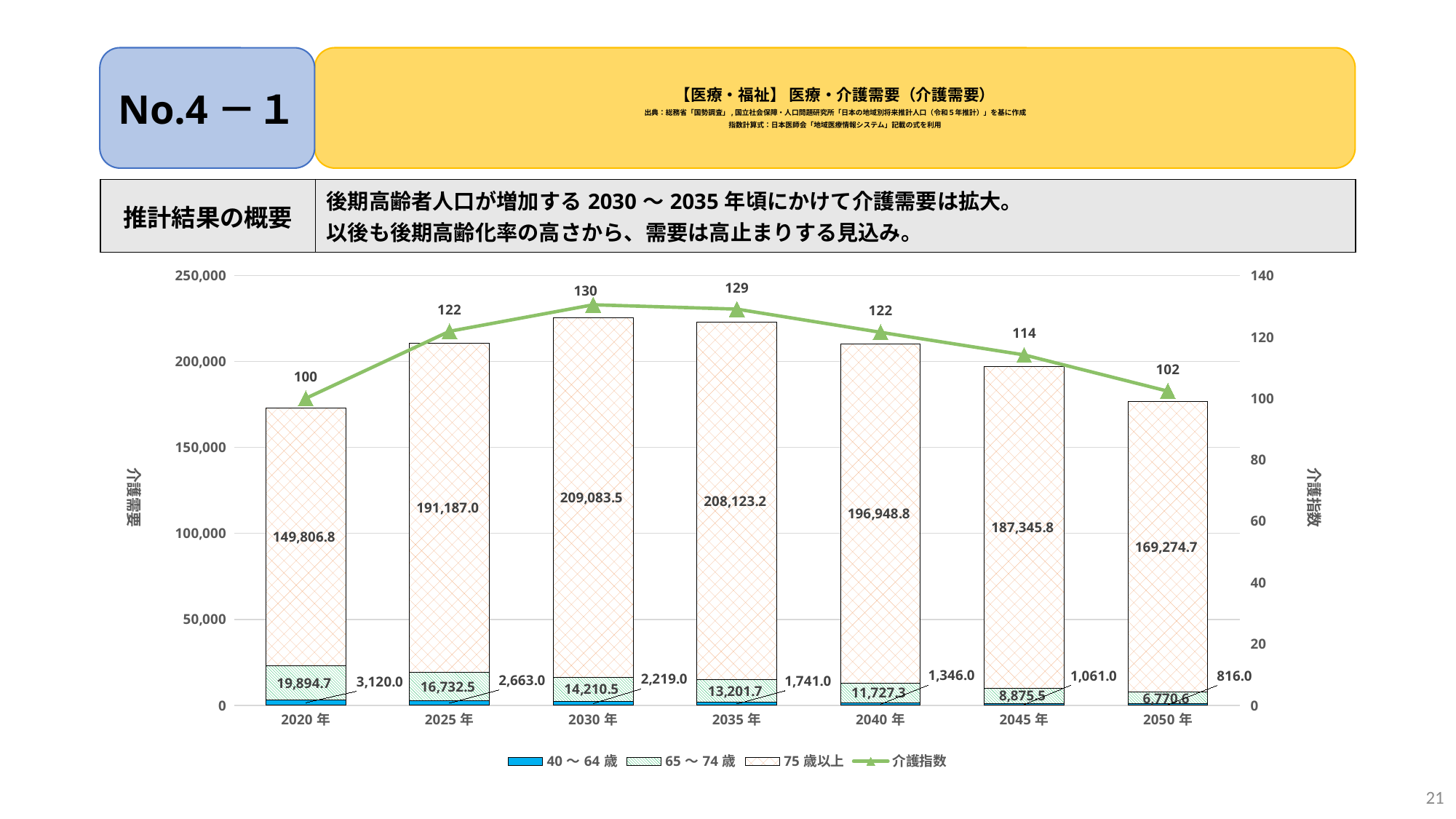
What is the 介護指数 value for 2045年? 114 In which year does the 介護指数 line reach its highest value? 2030年 How many years are shown on the x axis? 7 Which is larger, the 65～74歳 value for 2025年 or for 2040年? 2025年 What is the value of the 40～64歳 series for 2050年? 816.0 By how much does the 介護指数 fall from 2030年 to 2050年? 28 Which year has the lowest value for the 65～74歳 series? 2050年 What kind of chart is shown on the slide? Stacked bar chart with a line What is the difference between the 75歳以上 values for 2030年 and 2020年? 59,276.7 How many series does the legend list? 4 What is the value of the 75歳以上 series for 2030年? 209,083.5 What is the total of the stacked bar for 2020年? 172,821.5